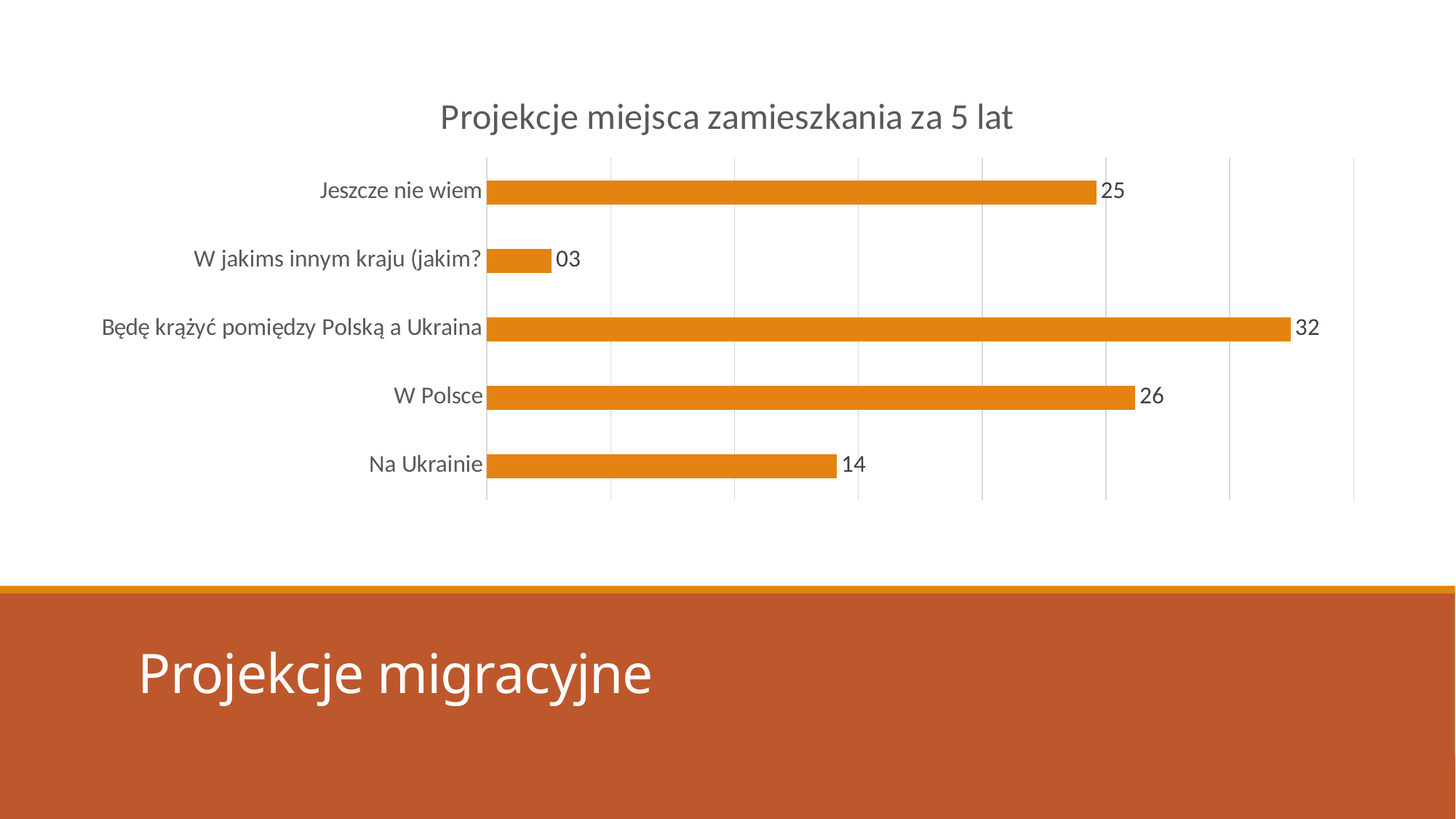
What is the value for "W jakims innym kraju (jakim?"? 03 What kind of chart is shown on the slide? Bar chart Which category has the highest value? Będę krążyć pomiędzy Polską a Ukraina What is the difference between the values for "W Polsce" and "Jeszcze nie wiem"? 1 What is the difference between the values for "Będę krążyć pomiędzy Polską a Ukraina" and "Na Ukrainie"? 18 What is the value for "Jeszcze nie wiem"? 25 What is the value for "W Polsce"? 26 Which is larger, the value for "W Polsce" or the value for "Na Ukrainie"? W Polsce How many categories are shown in the chart? 5 Which category has the lowest value? W jakims innym kraju (jakim? What is the value for "Na Ukrainie"? 14 What is the title of the chart? Projekcje miejsca zamieszkania za 5 lat